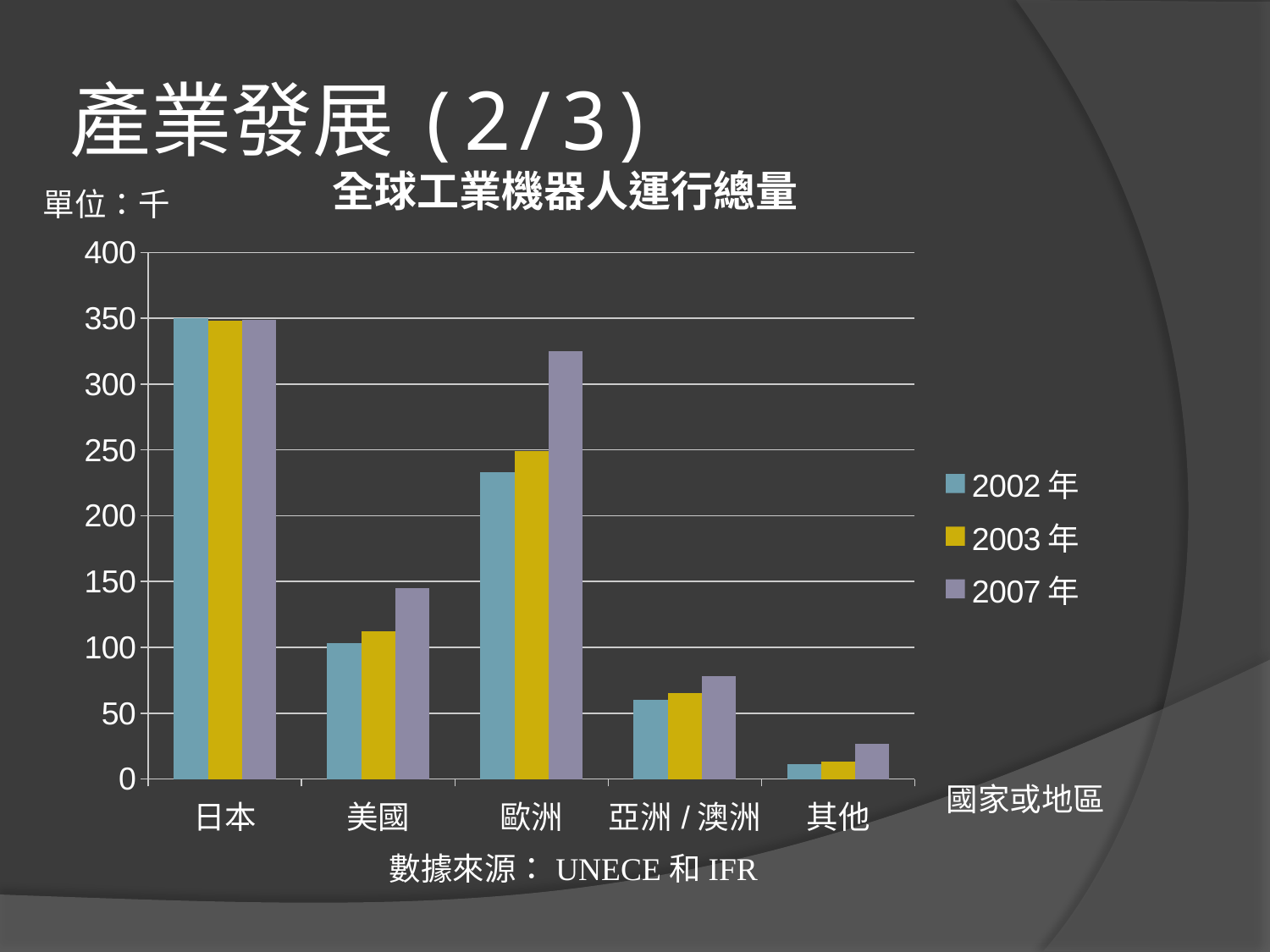
How many series does the chart's legend list? 3 Which country or region has the highest value for 2007 年? 日本 What is the title of the chart? 全球工業機器人運行總量 How many countries or regions are shown on the x axis of the chart? 5 Is the value for 歐洲 in 2007 年 greater or less than 300? greater For 美國, do the values rise or fall from 2002 年 to 2007 年? rise What kind of chart is shown on the slide? bar chart Is the value for 美國 in 2007 年 greater or less than 150? less Is the value for 歐洲 in 2002 年 greater or less than 200? greater Which is larger for 2007 年: the value for 歐洲 or the value for 美國? 歐洲 Which country or region has the lowest value for 2002 年? 其他